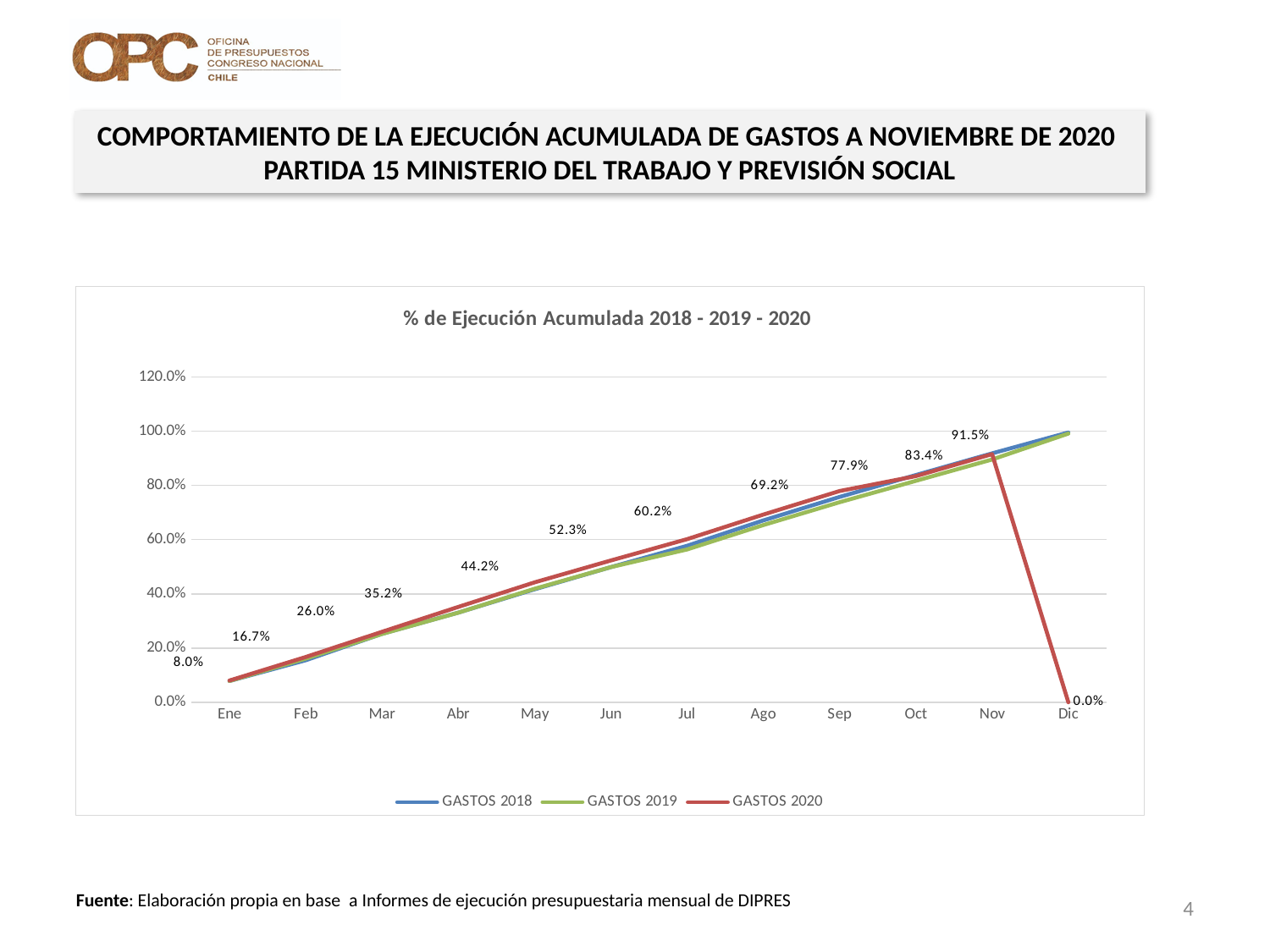
What is the difference between the GASTOS 2020 values for Nov and Oct? 8.1% Is the GASTOS 2020 value for Sep greater or less than 60.0%? greater Which month has the highest labelled value for GASTOS 2020? Nov How many months are shown on the x axis? 12 What is the value for GASTOS 2020 in Dic? 0.0% What type of chart is shown on the slide? line chart How many series does the legend list? 3 Does the GASTOS 2020 line rise or fall from Ene to Nov? rise What is the title of the chart? % de Ejecución Acumulada 2018 - 2019 - 2020 What is the value for GASTOS 2020 in Nov? 91.5% What is the value for GASTOS 2020 in Ene? 8.0% What is the value for GASTOS 2020 in Jun? 52.3%